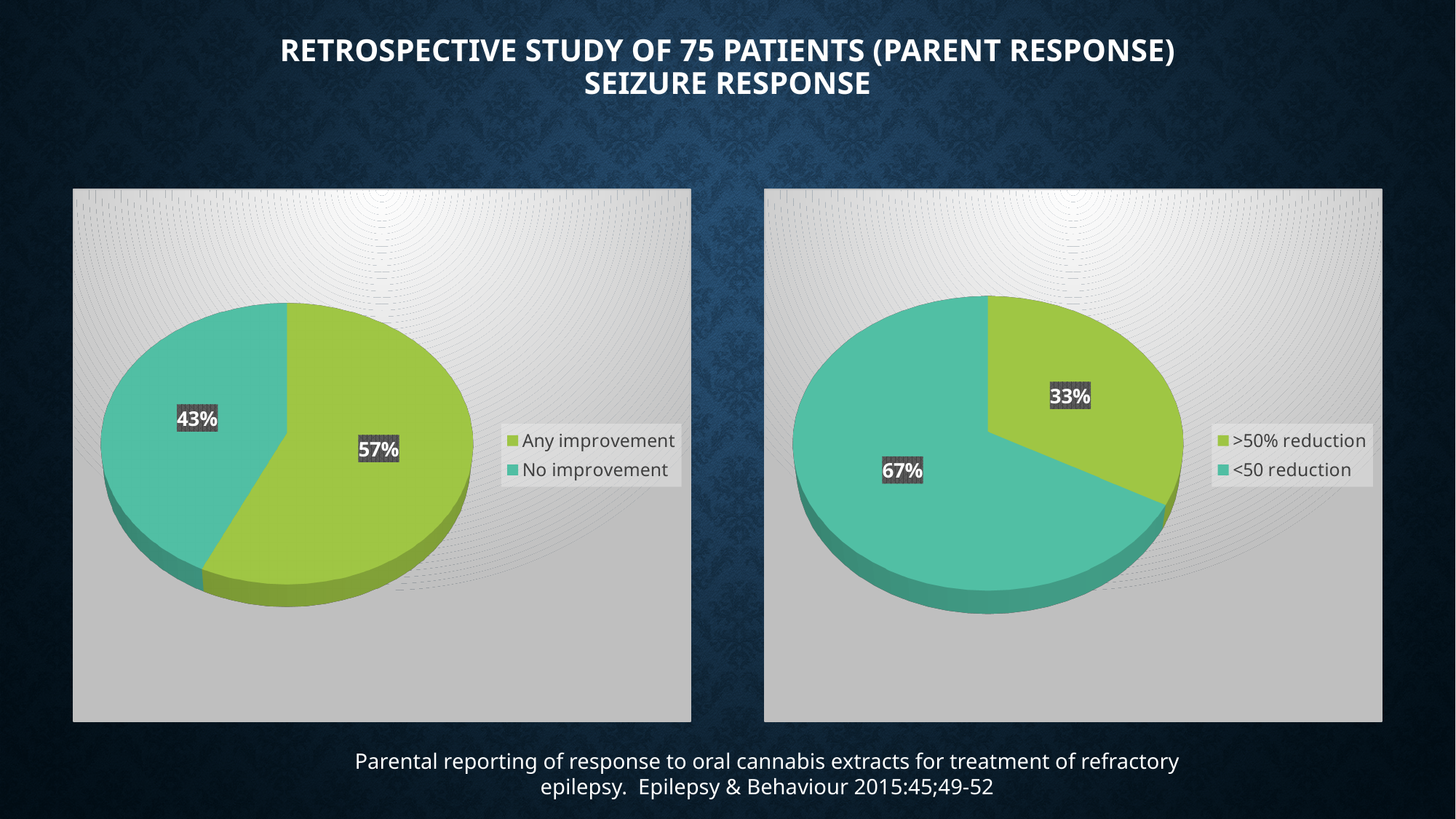
How many slices does the left pie chart have? 2 In the right pie chart, what percentage is shown for '>50% reduction'? 33% In the right pie chart, what is the difference in percentage points between '<50 reduction' and '>50% reduction'? 34 In the right pie chart, what percentage is shown for '<50 reduction'? 67% In the left pie chart, which slice is the largest? Any improvement In the right pie chart, which slice is the smallest? >50% reduction In the left pie chart, what is the difference in percentage points between 'Any improvement' and 'No improvement'? 14 What type of chart is shown on the right side of the slide? Pie chart In the left pie chart, what percentage is shown for 'No improvement'? 43% In the right pie chart, which is larger: '>50% reduction' or '<50 reduction'? <50 reduction In the left pie chart, what percentage is shown for 'Any improvement'? 57% In the right pie chart, what colour is the '<50 reduction' slice? Teal